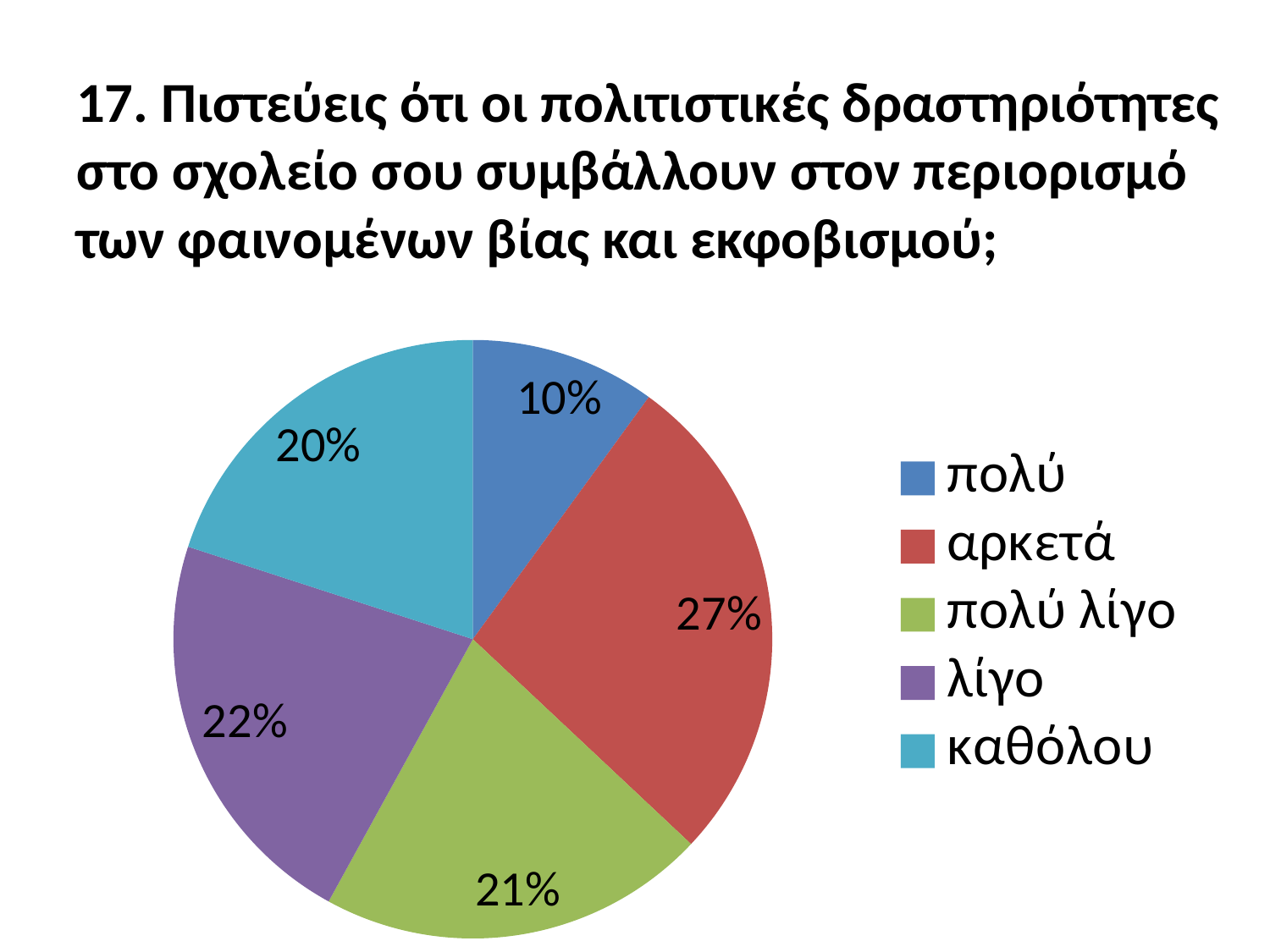
What share of the pie does the "λίγο" slice represent? 22% Which category has the smallest slice of the pie? πολύ What share of the pie does the "πολύ λίγο" slice represent? 21% Which category has the largest slice of the pie? αρκετά What is the difference between the "αρκετά" share and the "πολύ" share? 17% What share of the pie does the "αρκετά" slice represent? 27% What kind of chart is shown on the slide? pie chart Which is larger, the share for "λίγο" or the share for "καθόλου"? λίγο How many categories does the pie chart show? 5 Which colour represents "καθόλου" in the legend? light blue